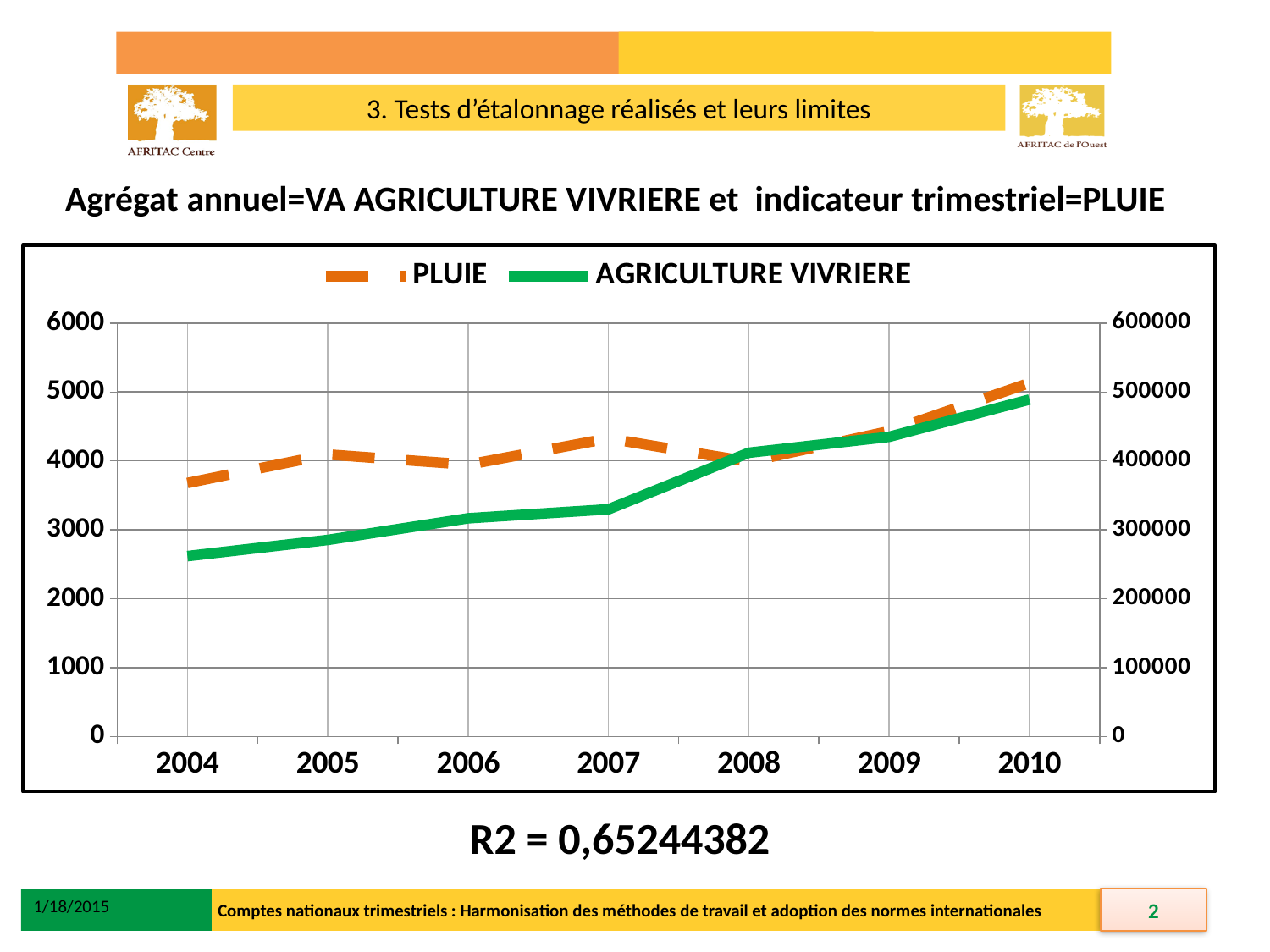
In which year is the PLUIE series at its highest? 2010 How many years are plotted along the x axis of the chart? 7 Is the AGRICULTURE VIVRIERE value for 2007 greater or less than 400000? less Which year has the larger AGRICULTURE VIVRIERE value, 2007 or 2008? 2008 In which year is the PLUIE series at its lowest? 2004 In which year is the AGRICULTURE VIVRIERE series at its lowest? 2004 Which series is drawn with a dashed orange line? PLUIE Is the PLUIE value for 2007 greater or less than 4000? greater Is the PLUIE value for 2004 greater or less than 4000? less How many series does the chart legend list? 2 Does the AGRICULTURE VIVRIERE line rise or fall from 2004 to 2010? rise What kind of chart is shown on the slide? line chart